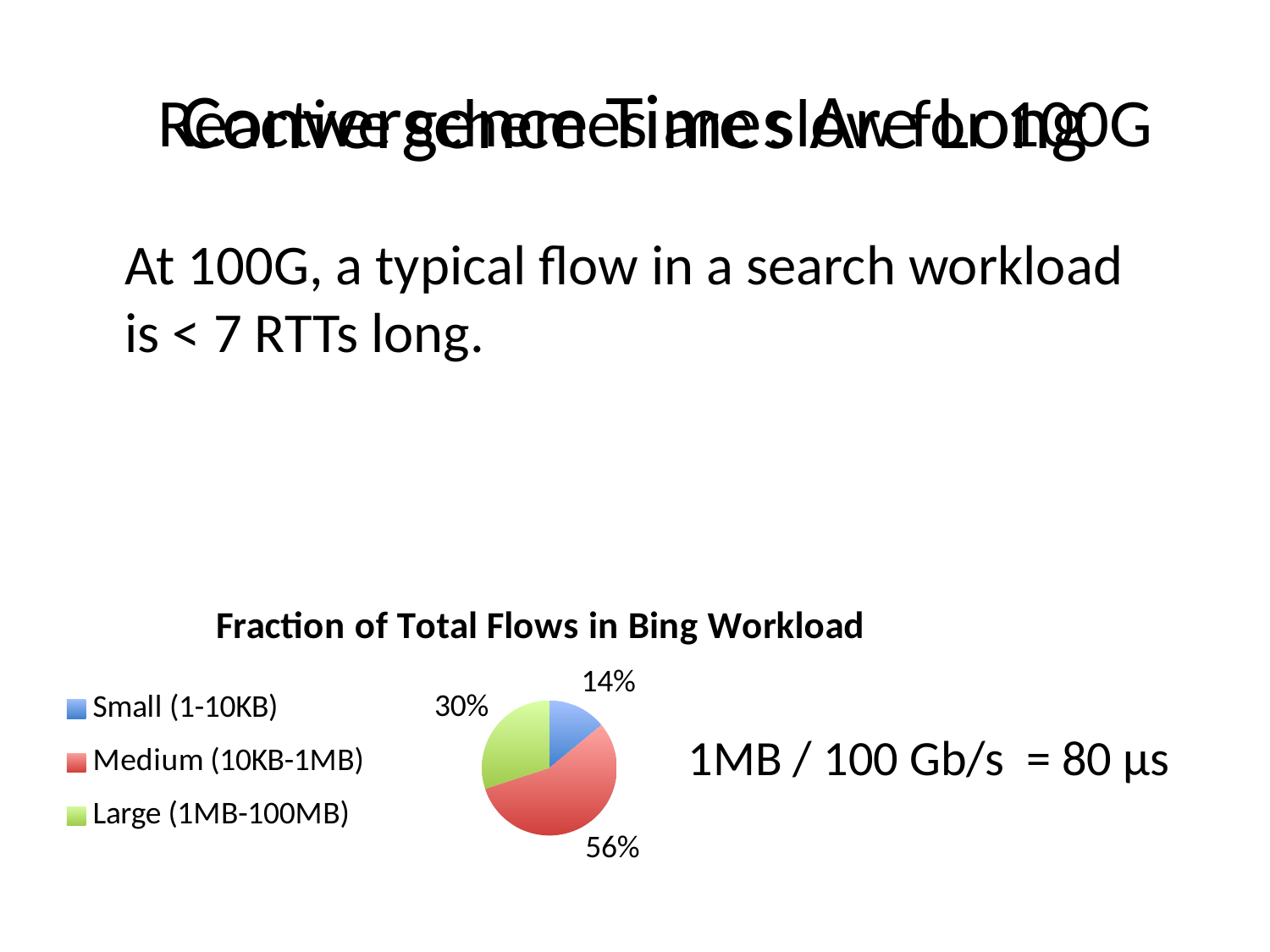
What is the difference in share between Large (1MB-100MB) and Small (1-10KB)? 16% Which has a larger share of total flows, Large (1MB-100MB) or Small (1-10KB)? Large (1MB-100MB) What colour is the Medium (10KB-1MB) slice in the pie chart? red What kind of chart is shown on the slide? pie chart Which flow size category has the largest share of total flows? Medium (10KB-1MB) How many categories does the pie chart show? 3 What is the title of the chart? Fraction of Total Flows in Bing Workload What share of total flows is Large (1MB-100MB)? 30% What share of total flows is Small (1-10KB)? 14% Which flow size category has the smallest share of total flows? Small (1-10KB) What share of total flows is Medium (10KB-1MB)? 56% What is the difference in share between Medium (10KB-1MB) and Large (1MB-100MB)? 26%